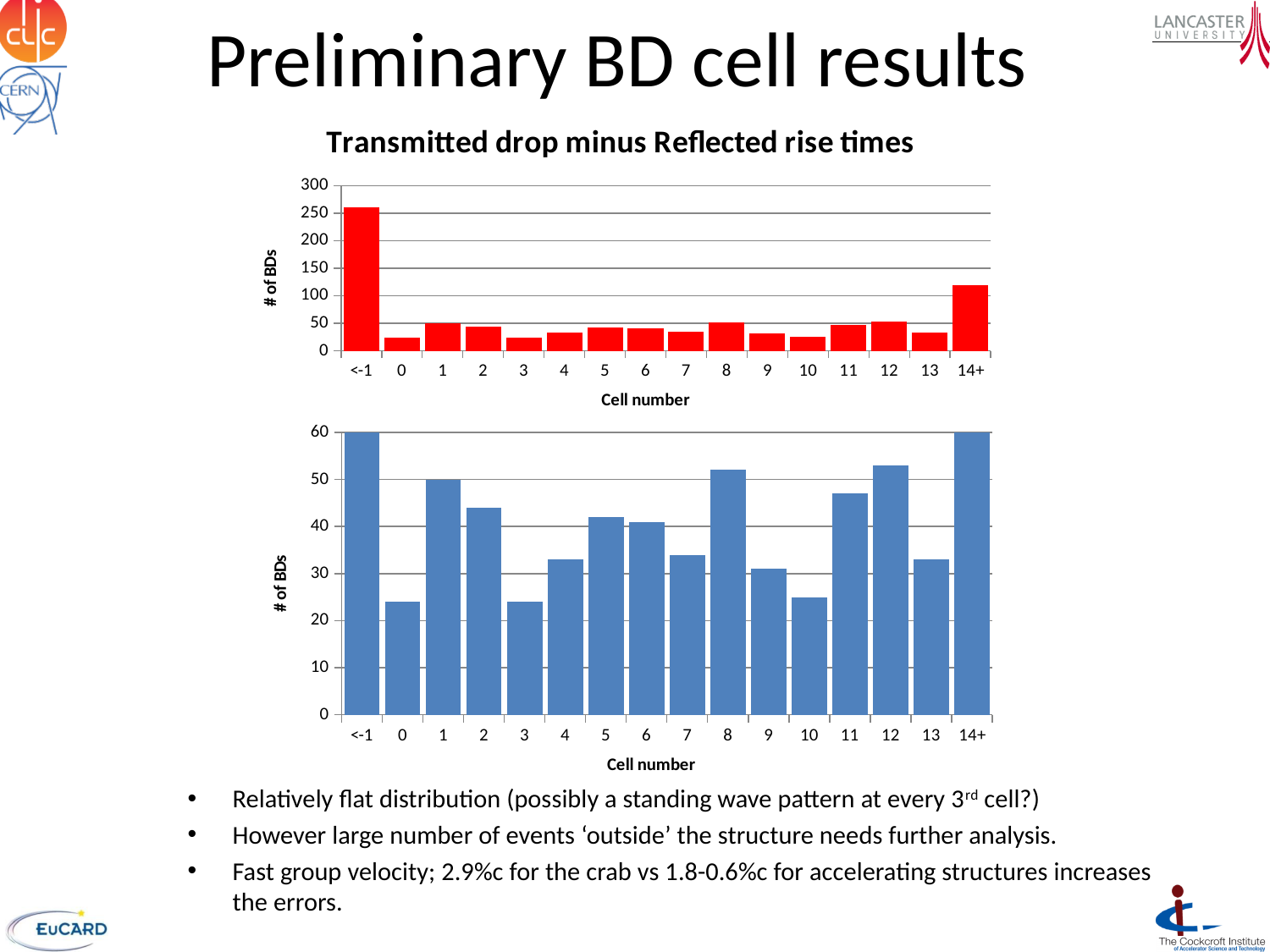
In the bottom chart, is the value for cell number 3 greater or less than 30? less How many cell number categories are shown on the x axis of the top chart? 16 In the bottom chart, is the value for cell number 11 greater or less than 40? greater In the top chart, which is larger, the value for <-1 or the value for 14+? <-1 What is the title of the top chart? Transmitted drop minus Reflected rise times In the top chart, is the value for cell number 14+ greater or less than 100? greater In the top chart, which cell number category has the highest number of BDs? <-1 What kind of chart is the top chart titled 'Transmitted drop minus Reflected rise times'? bar chart In the bottom chart, which is larger, the value for cell number 8 or the value for cell number 9? 8 What is the x-axis label of the bottom chart? Cell number